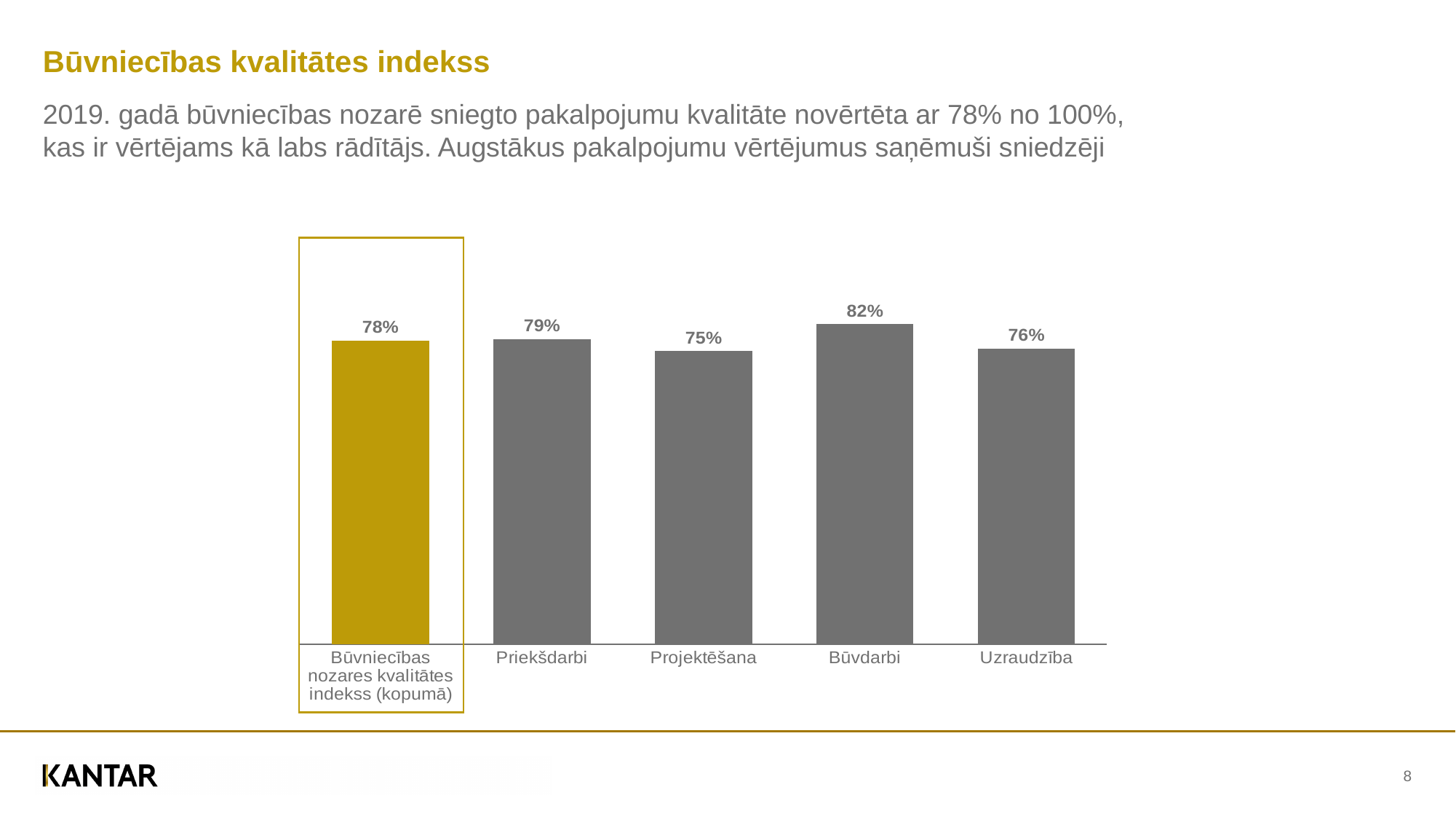
What is the difference between the values for Priekšdarbi and Uzraudzība? 3% What is the value for Uzraudzība? 76% Which category has the lowest value? Projektēšana Which is larger, the value for Priekšdarbi or the value for Uzraudzība? Priekšdarbi What is the difference between the values for Būvdarbi and Projektēšana? 7% Which category has the highest value? Būvdarbi What is the value for Būvdarbi? 82% What is the value for Projektēšana? 75% What is the value for Būvniecības nozares kvalitātes indekss (kopumā)? 78% How many categories are shown in the chart? 5 Which bar is highlighted in a gold colour and outlined with a box? Būvniecības nozares kvalitātes indekss (kopumā) What kind of chart is shown on the slide? Bar chart